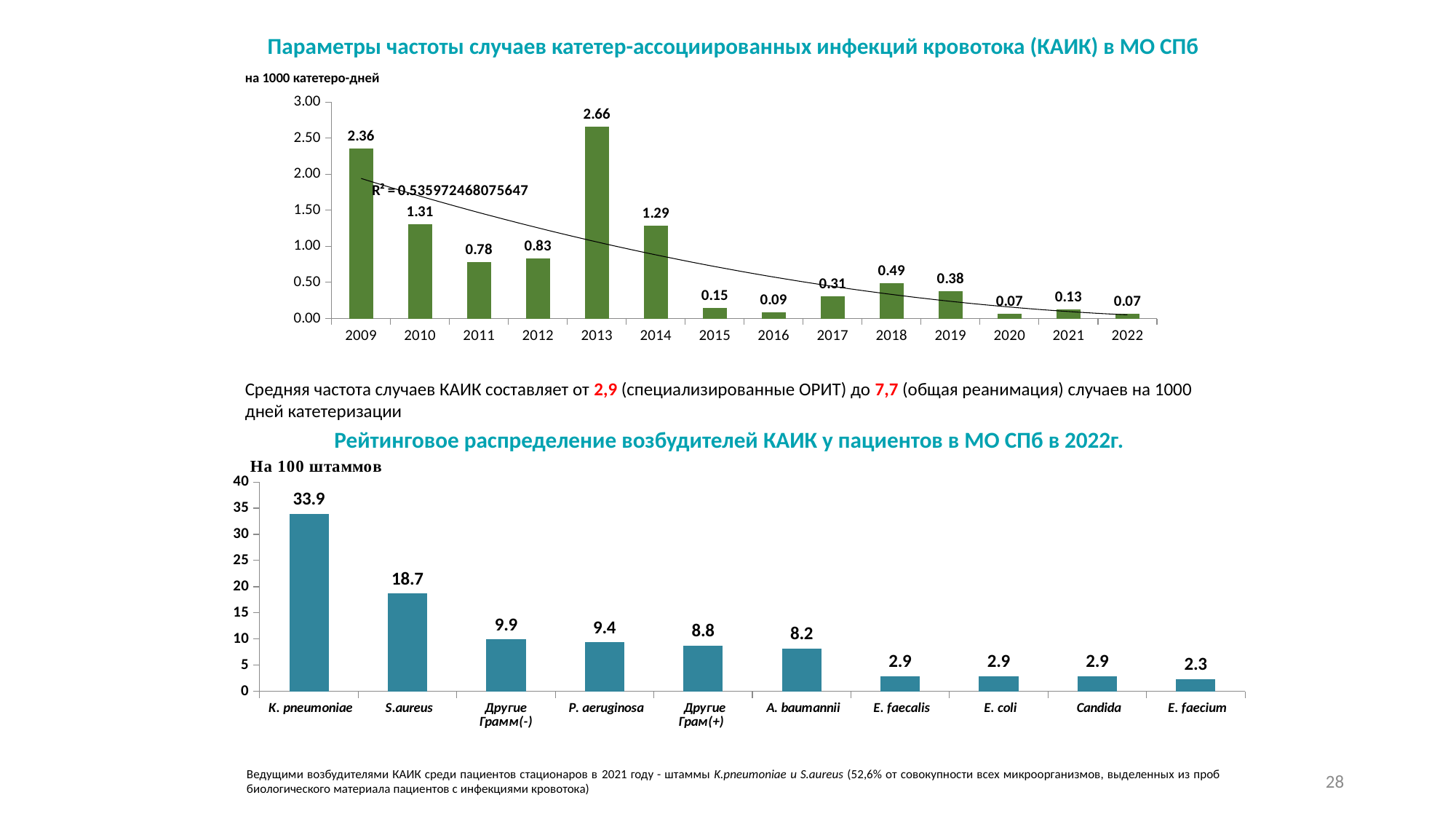
In the bottom chart (Рейтинговое распределение возбудителей КАИК), what is the value for S.aureus? 18.7 In the top chart (Параметры частоты случаев КАИК), what is the overall trend of the values from 2009 to 2022? falling In the top chart (Параметры частоты случаев КАИК), what is the value for 2009? 2.36 In the top chart (Параметры частоты случаев КАИК), how many years are shown on the x axis? 14 In the bottom chart (Рейтинговое распределение возбудителей КАИК), which pathogen has the lowest value? E. faecium In the top chart (Параметры частоты случаев КАИК), what is the difference between the values for 2013 and 2014? 1.37 What kind of chart is the bottom chart (Рейтинговое распределение возбудителей КАИК)? bar chart In the bottom chart (Рейтинговое распределение возбудителей КАИК), which is larger: the value for P. aeruginosa or the value for A. baumannii? P. aeruginosa In the top chart (Параметры частоты случаев КАИК), what is the value for 2013? 2.66 In the bottom chart (Рейтинговое распределение возбудителей КАИК), which pathogen has the highest value? K. pneumoniae In the top chart (Параметры частоты случаев КАИК), which year has the highest value? 2013 In the top chart (Параметры частоты случаев КАИК), is the value for 2010 greater or less than 1.00? greater